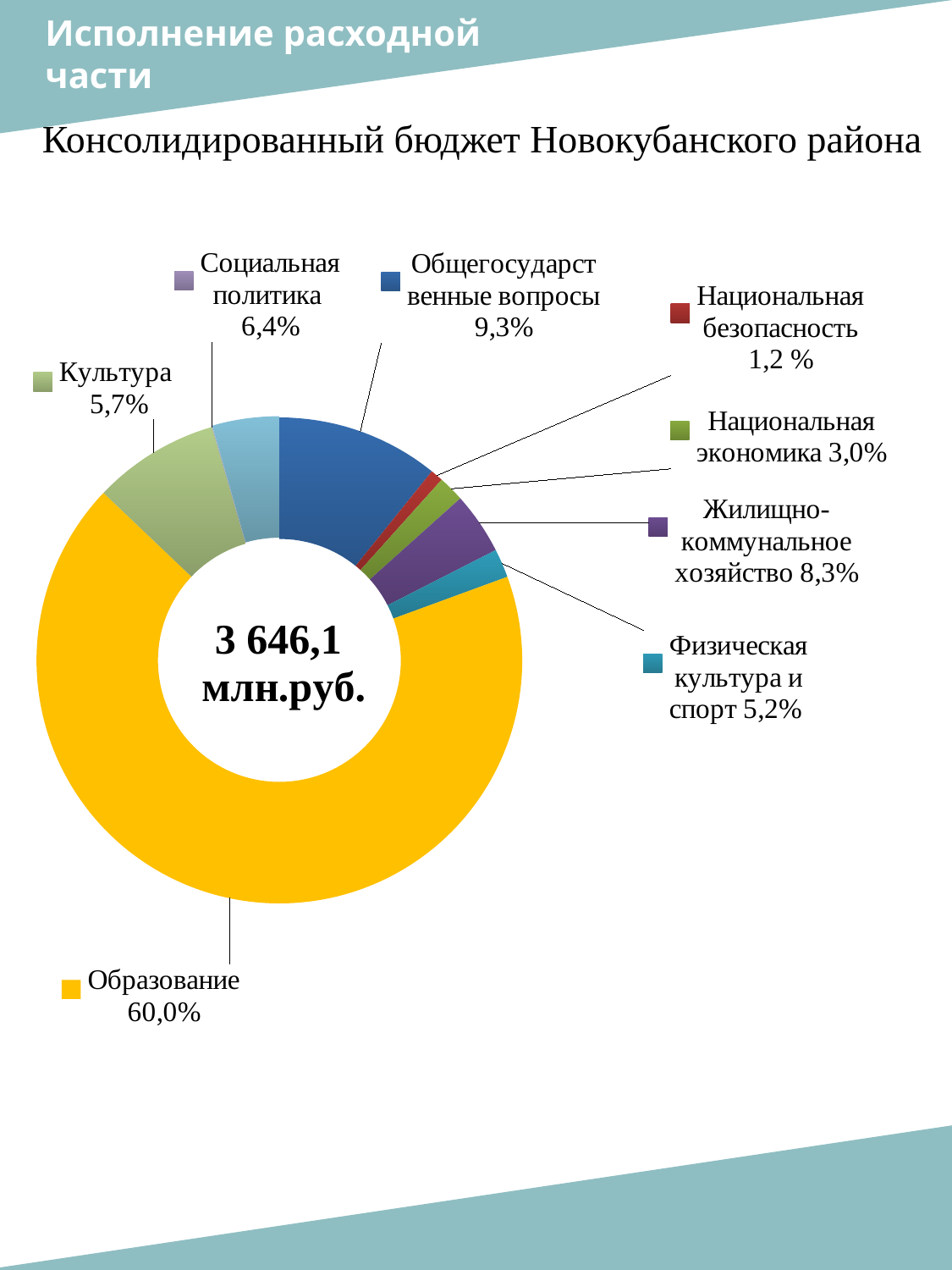
What total amount is printed in the centre of the chart? 3 646,1 млн.руб. What share of the budget goes to Образование? 60,0% Which is larger: the share for Общегосударственные вопросы or for Жилищно-коммунальное хозяйство? Общегосударственные вопросы What share is shown for Физическая культура и спорт? 5,2% Which category has the largest share of the budget? Образование What share is shown for Жилищно-коммунальное хозяйство? 8,3% What share is shown for Общегосударственные вопросы? 9,3% Which category has the smallest share of the budget? Национальная безопасность How many categories are shown in the chart? 8 What kind of chart is shown on the slide? Doughnut (pie) chart What is the difference in percentage points between Социальная политика and Культура? 0,7 What share is shown for Национальная безопасность? 1,2 %